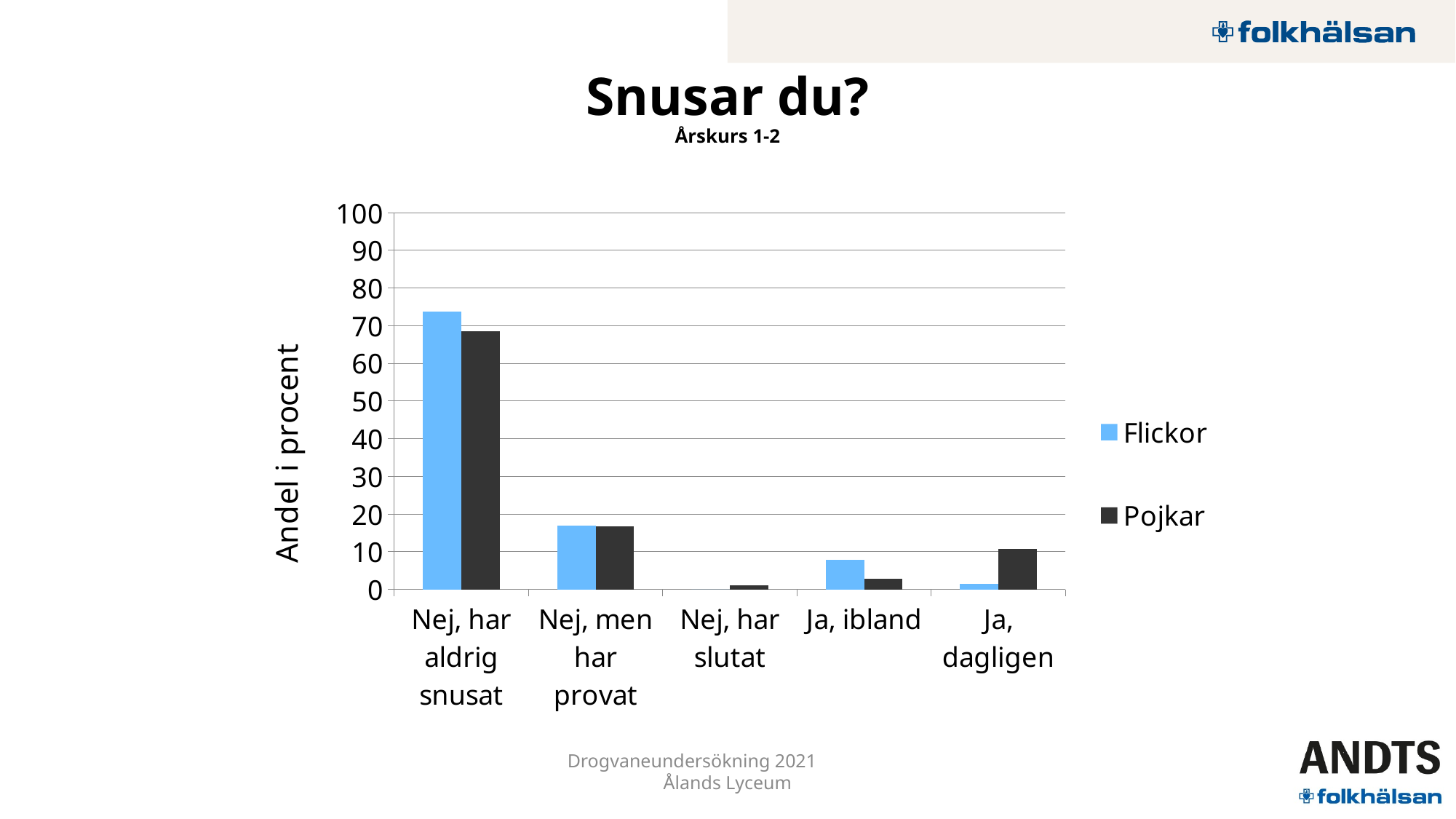
For 'Ja, ibland', which series has the larger value, Flickor or Pojkar? Flickor How many series does the legend list? 2 Is the Pojkar value for 'Nej, har aldrig snusat' greater or less than 60? greater What kind of chart is shown on the slide? bar chart For 'Ja, dagligen', which series has the larger value, Flickor or Pojkar? Pojkar Which category has the highest value for Pojkar? Nej, har aldrig snusat Which category has the lowest value for Pojkar? Nej, har slutat What is the title of the y axis? Andel i procent For 'Nej, har aldrig snusat', which series has the larger value, Flickor or Pojkar? Flickor How many categories are shown on the x axis? 5 Is the Flickor value for 'Nej, har aldrig snusat' greater or less than 70? greater Which category has the highest value for Flickor? Nej, har aldrig snusat